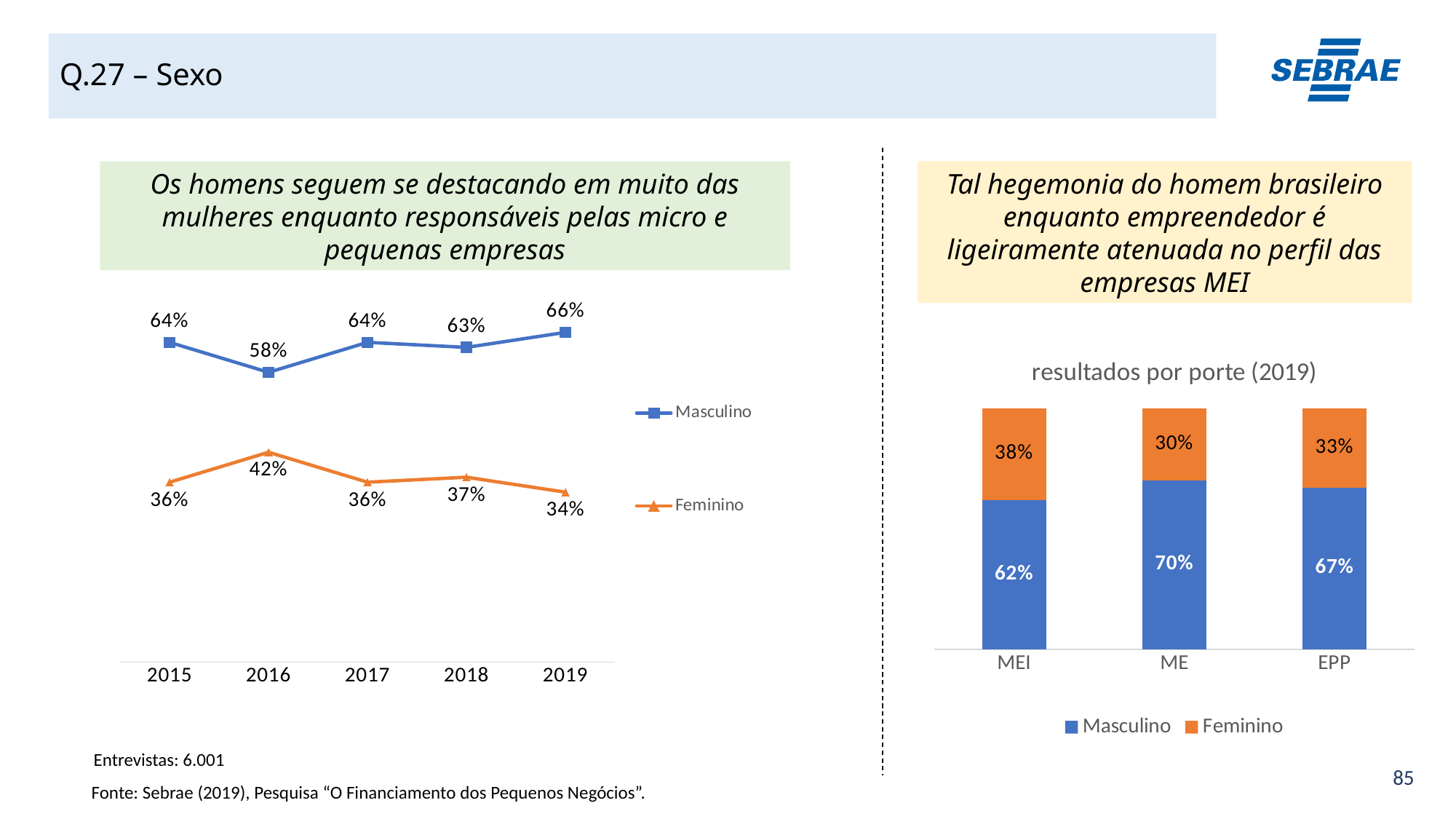
In the line chart on the left, how many years are shown on the x axis? 5 In the chart titled 'resultados por porte (2019)', what is the total of the stacked bar for EPP? 100% In the line chart on the left, what is the difference between the Masculino and Feminino values in 2015? 28% In the chart titled 'resultados por porte (2019)', which category has the highest Feminino share? MEI In the chart titled 'resultados por porte (2019)', what is the Feminino value for MEI? 38% In the line chart on the left, what is the Feminino value for 2019? 34% In the line chart on the left, how many series does the legend list? 2 In the line chart on the left, which year has the highest Masculino value? 2019 In the chart titled 'resultados por porte (2019)', what is the Masculino value for ME? 70% In the line chart on the left, which year has the lowest Feminino value? 2019 In the line chart on the left, what is the Masculino value for 2016? 58% What kind of chart is the one titled 'resultados por porte (2019)'? Stacked bar chart